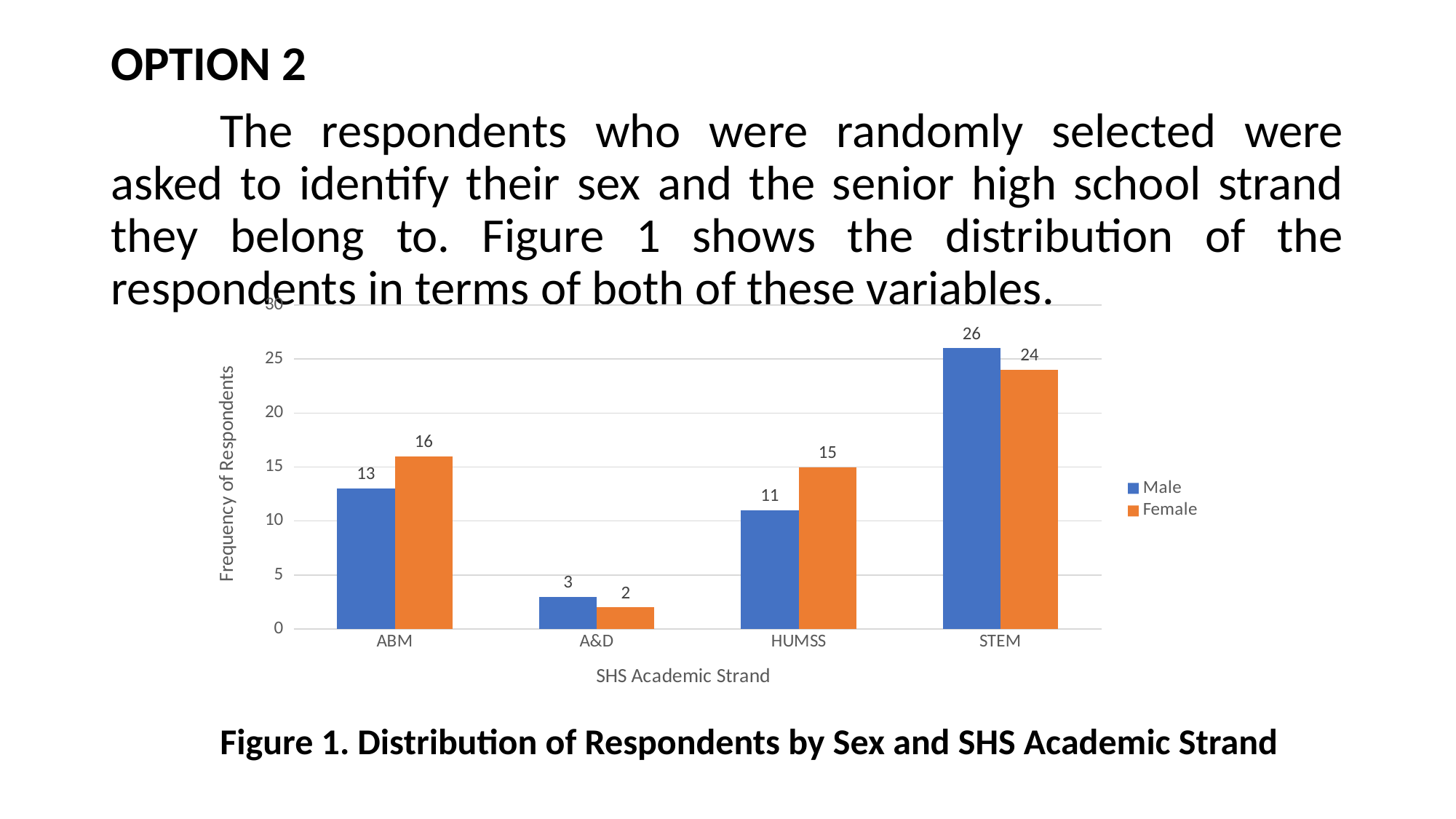
What is the number of Male respondents in the ABM strand? 13 Is the value for Male respondents in STEM greater or less than 25? greater Which SHS academic strand has the highest number of Male respondents? STEM What is the number of Female respondents in the A&D strand? 2 What is the difference between the Male and Female respondents in the STEM strand? 2 Which SHS academic strand has the lowest number of Female respondents? A&D What is the number of Female respondents in the HUMSS strand? 15 How many SHS academic strands are shown on the x axis? 4 What kind of chart is shown on the slide? Bar chart Which is larger in the ABM strand, the number of Male or Female respondents? Female What is the label of the vertical axis? Frequency of Respondents How many series does the legend list? 2